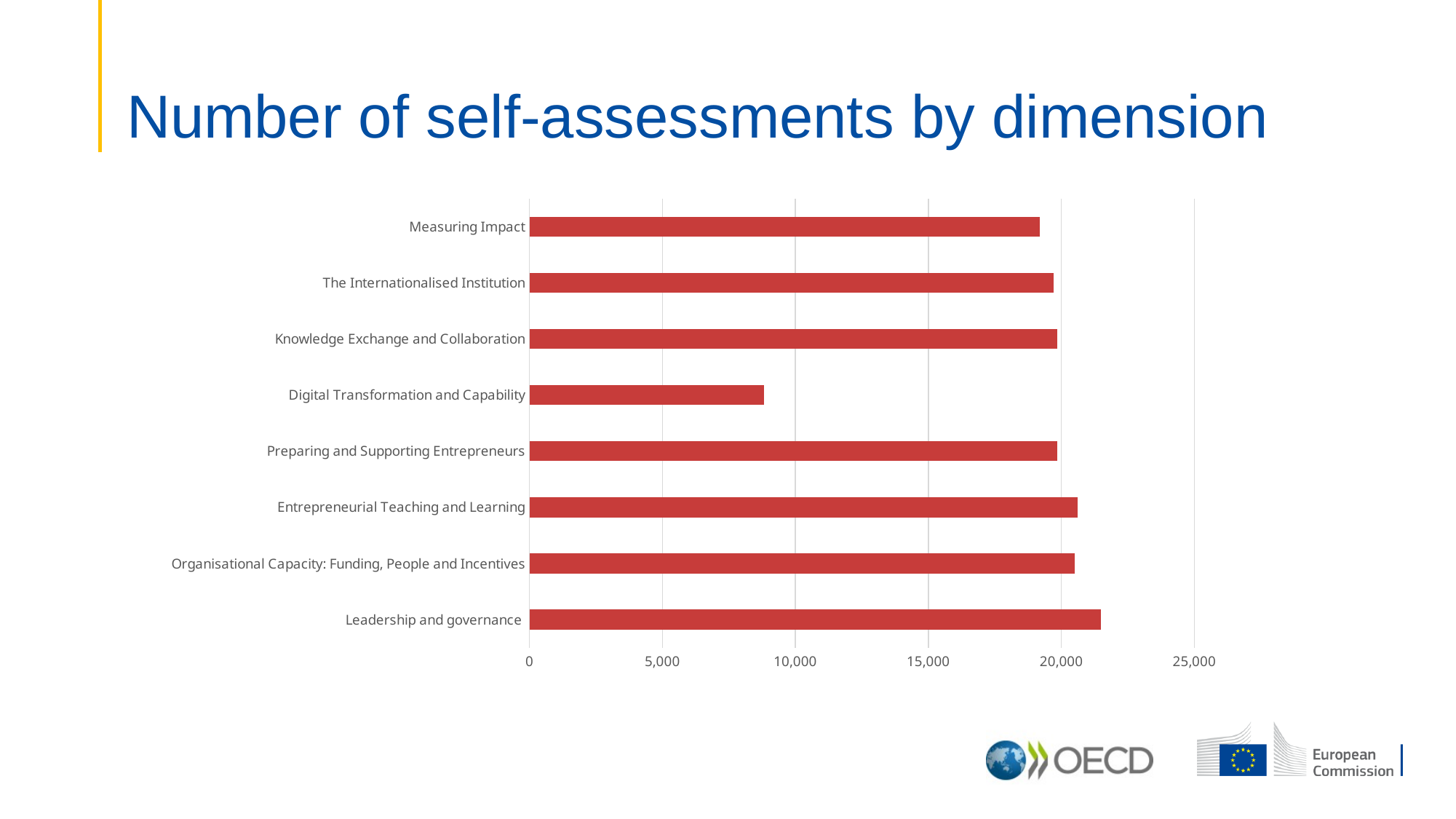
Which dimension has the highest number of self-assessments? Leadership and governance What kind of chart is shown on the slide? bar chart Which has more self-assessments: Leadership and governance or Digital Transformation and Capability? Leadership and governance Is the value for Digital Transformation and Capability greater or less than 5,000? greater What colour are the bars in the chart? red Which has more self-assessments: Leadership and governance or Measuring Impact? Leadership and governance How many dimensions (categories) are shown in the chart? 8 Is the value for Measuring Impact greater or less than 20,000? less Is the value for Digital Transformation and Capability greater or less than 10,000? less Which dimension has the lowest number of self-assessments? Digital Transformation and Capability What is the title of the chart on the slide? Number of self-assessments by dimension